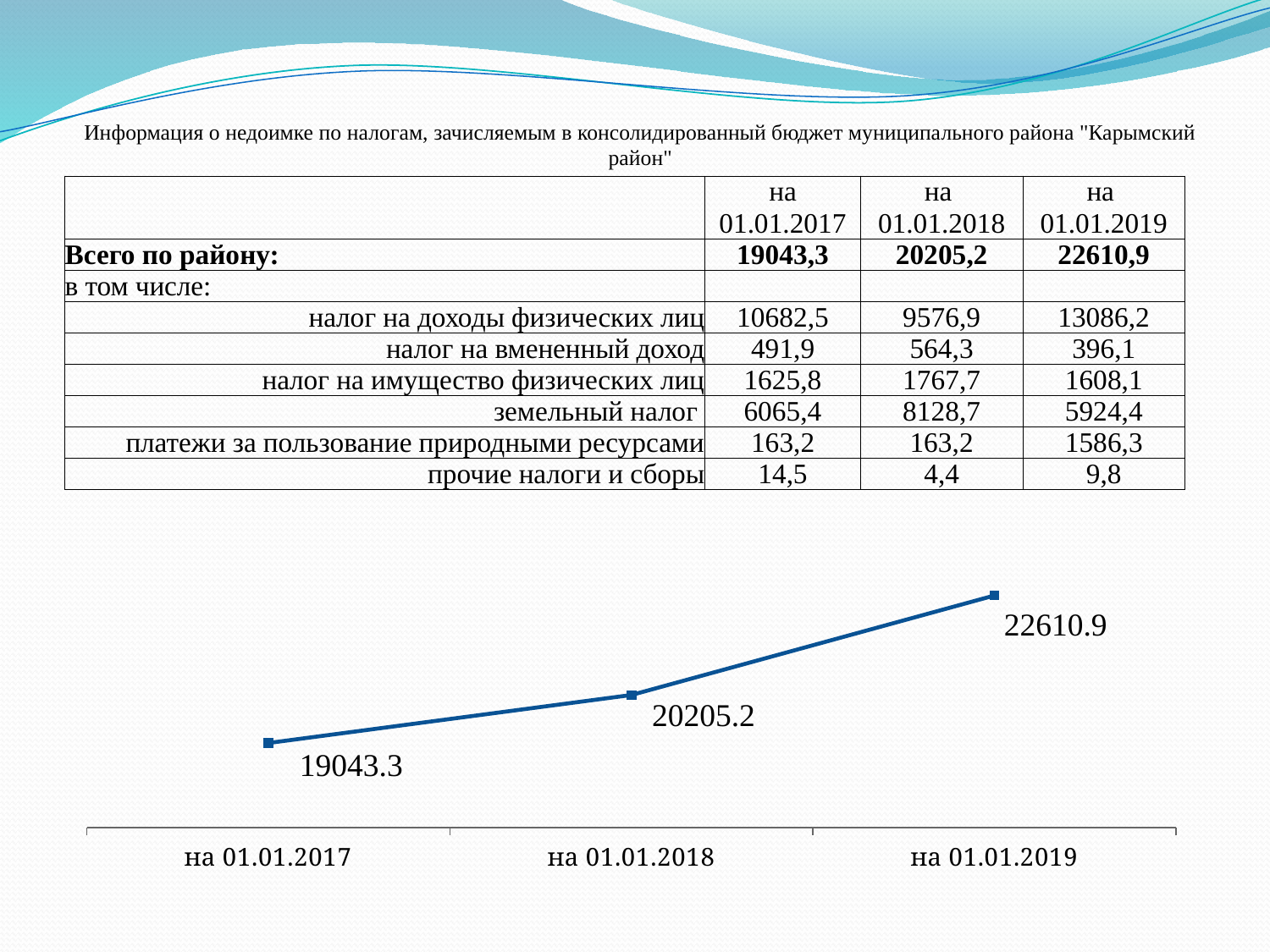
In the line chart, what is the value for на 01.01.2017? 19043.3 In the line chart, what is the value for на 01.01.2018? 20205.2 In the line chart, what is the value for на 01.01.2019? 22610.9 In the line chart, what is the difference between the values for на 01.01.2019 and на 01.01.2018? 2405.7 In the line chart, which date has the lowest value? на 01.01.2017 Do the values in the line chart rise or fall from на 01.01.2017 to на 01.01.2019? rise In the line chart, what is the difference between the values for на 01.01.2018 and на 01.01.2017? 1161.9 In the line chart, which date has the highest value? на 01.01.2019 How many data points are plotted in the line chart? 3 In the line chart, which is larger: the value for на 01.01.2018 or the value for на 01.01.2019? на 01.01.2019 In the line chart, what is the difference between the values for на 01.01.2019 and на 01.01.2017? 3567.6 What type of chart is shown at the bottom of the slide? line chart